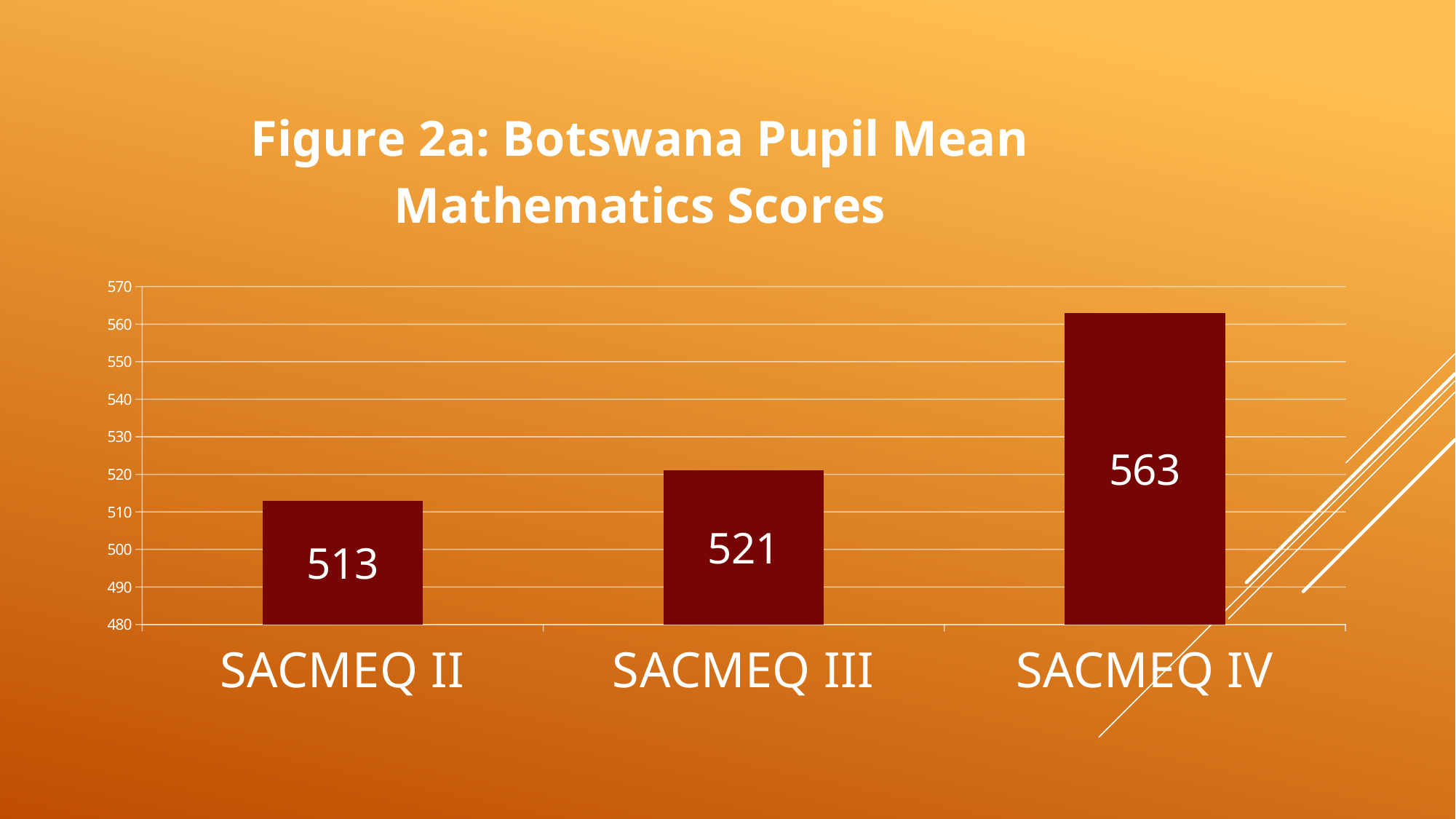
What is the mean mathematics score for SACMEQ III? 521 What is the mean mathematics score for SACMEQ IV? 563 What is the difference between the SACMEQ IV and SACMEQ II scores? 50 What kind of chart is shown on the slide? Bar chart Which SACMEQ round has the highest mean mathematics score? SACMEQ IV What is the difference between the SACMEQ III and SACMEQ II scores? 8 How many SACMEQ rounds are shown on the chart? 3 Which is larger, the score for SACMEQ III or SACMEQ IV? SACMEQ IV Is the value for SACMEQ IV greater or less than 550? greater What is the mean mathematics score for SACMEQ II? 513 Do the mean mathematics scores rise or fall from SACMEQ II to SACMEQ IV? Rise Which SACMEQ round has the lowest mean mathematics score? SACMEQ II